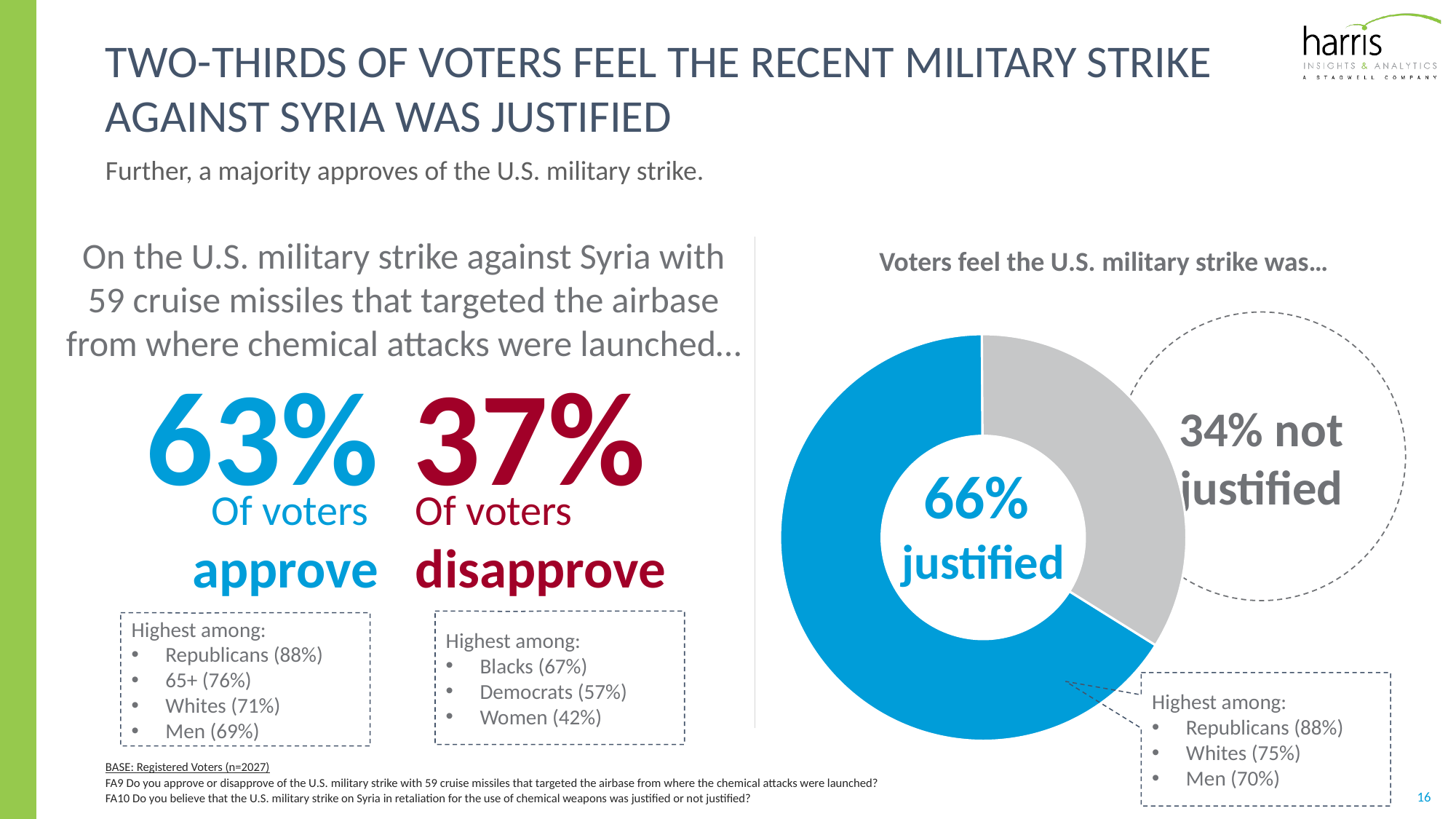
How many segments does the donut chart on the right of the slide have? 2 What is the title of the donut chart on the right of the slide? Voters feel the U.S. military strike was... In the donut chart on the right of the slide, what colour is the "justified" segment? Blue In the donut chart on the right of the slide, by how many percentage points does "justified" exceed "not justified"? 32 percentage points In the donut chart on the right of the slide, is the share for "not justified" greater or less than 50%? less In the donut chart titled "Voters feel the U.S. military strike was...", what share of voters feel the strike was justified? 66% In the donut chart on the right of the slide, which response has the larger share: justified or not justified? justified In the donut chart on the right of the slide, which response has the smaller share? not justified In the donut chart on the right of the slide, what is the combined share of the justified and not justified segments? 100% In the donut chart on the right of the slide, is the share for "justified" larger or smaller than the share for "not justified"? larger What type of chart is shown on the right of the slide under "Voters feel the U.S. military strike was..."? Donut (pie) chart In the donut chart titled "Voters feel the U.S. military strike was...", what share of voters feel the strike was not justified? 34%